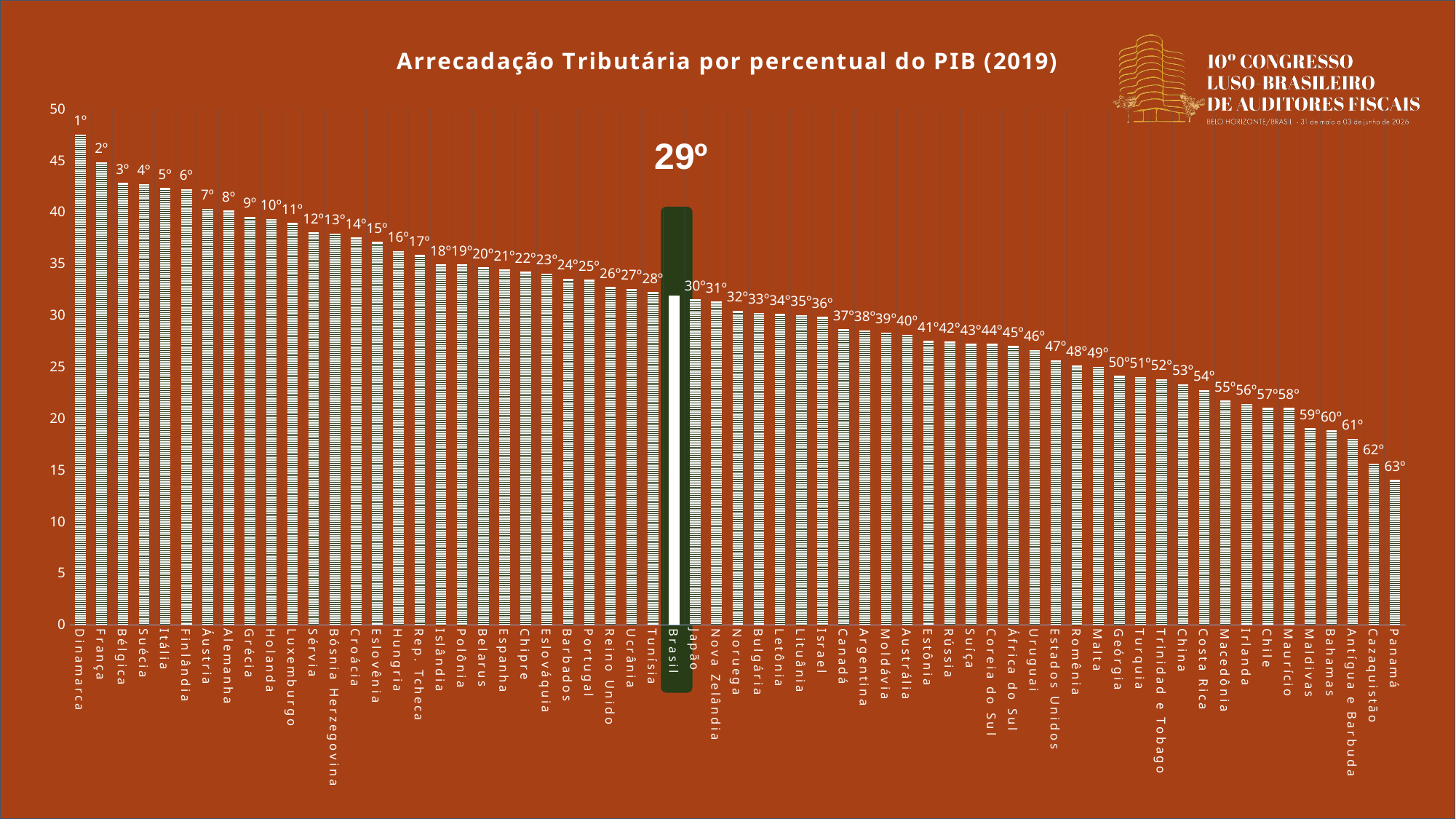
Which country has the highest tax revenue as a percentage of GDP in the chart? Dinamarca Is the value for Panamá greater or less than 15? less Do the values rise or fall moving from left to right along the x axis? fall Is the value for Brasil greater or less than 30? greater Is the value for Dinamarca greater or less than 45? greater What rank label is shown above the bar for Brasil? 29º What rank label is shown above the bar for França? 2º Which country has the lowest tax revenue as a percentage of GDP in the chart? Panamá What is the title of the chart? Arrecadação Tributária por percentual do PIB (2019) How many countries are plotted in the chart? 63 What kind of chart is shown on the slide? bar chart Which has a higher value, Brasil or Estados Unidos? Brasil